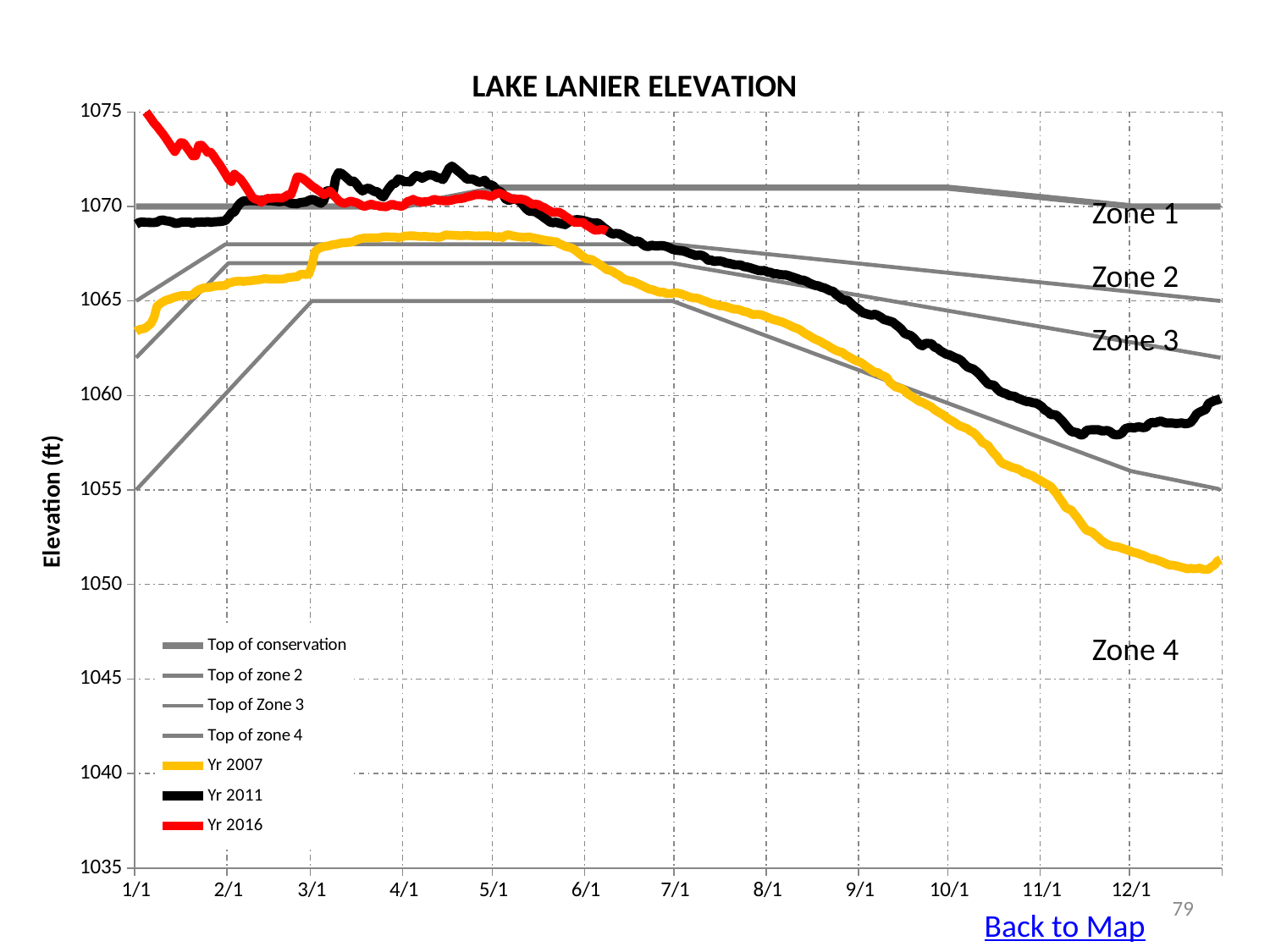
What is the value of the Top of conservation line at 1/1? 1070 Does the Yr 2007 line rise or fall between 5/1 and 12/1? Fall Which is higher at 12/1, the Yr 2011 line or the Yr 2007 line? Yr 2011 Is the value of the Yr 2016 line at 2/1 greater or less than 1070? greater How many series does the legend list? 7 What is the value of the Top of zone 4 line at 1/1? 1055 What is the value of the Top of zone 4 line between 3/1 and 7/1? 1065 What is the label of the vertical axis? Elevation (ft) Is the value of the Yr 2011 line at 12/1 greater or less than 1055? greater What type of chart is shown on the slide? Line chart Is the value of the Yr 2007 line at 12/1 greater or less than 1055? less What is the title of the chart? LAKE LANIER ELEVATION